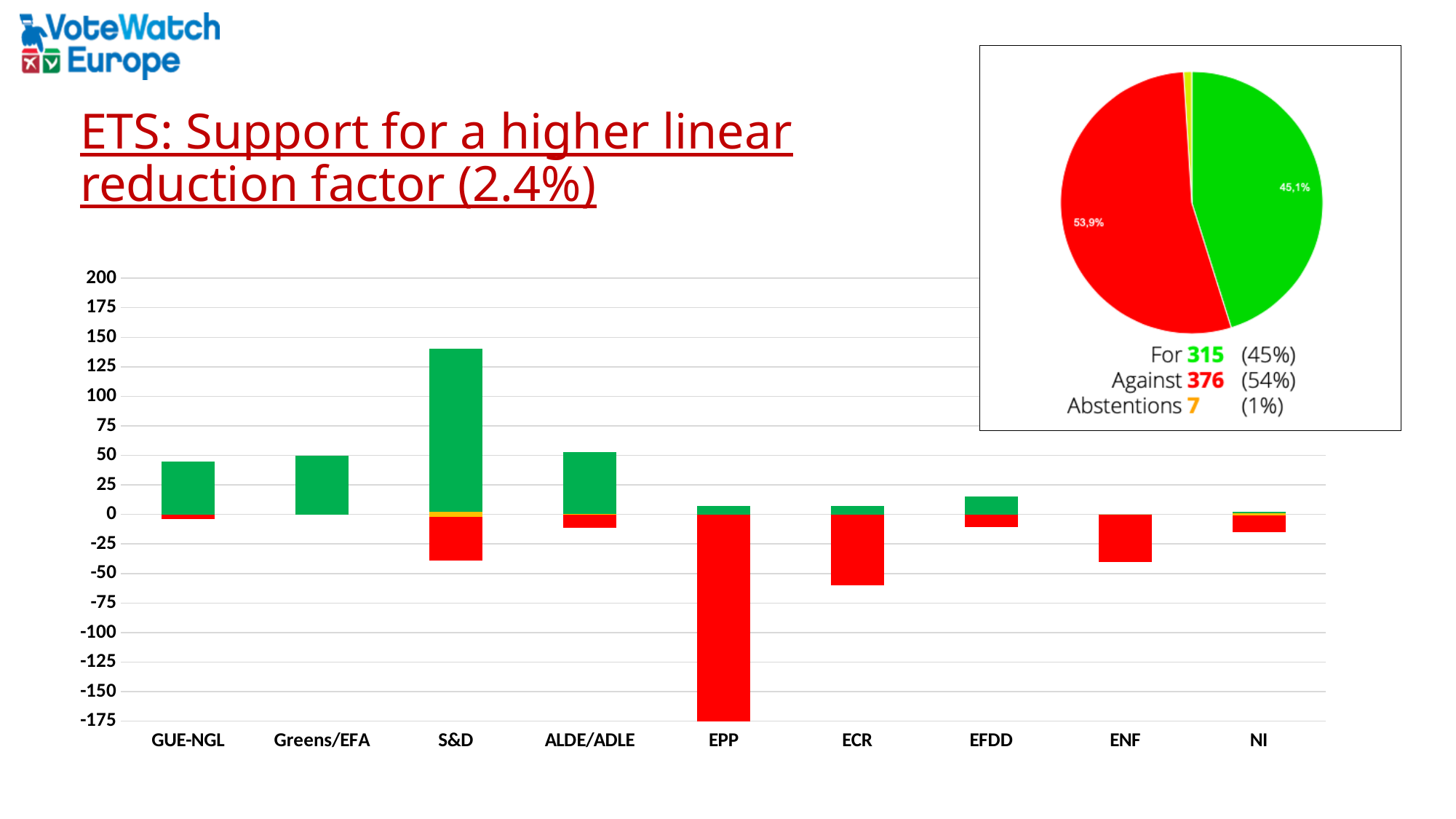
In the pie chart, what share of the votes were for? 45% What kind of chart is shown in the box at the top right of the slide? pie chart In the pie chart, how many votes were cast against? 376 In the bar chart, is the red bar for EPP greater or less than -150? less In the bar chart, how many political groups are shown on the x axis? 9 In the bar chart, which group has the larger green bar, Greens/EFA or EFDD? Greens/EFA In the bar chart, which group has the tallest green (positive) bar? S&D In the bar chart, which group has the longest red (negative) bar? EPP In the bar chart, is the green bar for S&D greater or less than 125? greater In the pie chart, what is the difference between the number of votes against and the number of votes for? 61 In the bar chart, is the red bar for ENF greater or less than -25? less What kind of chart is the large chart on the left of the slide? bar chart